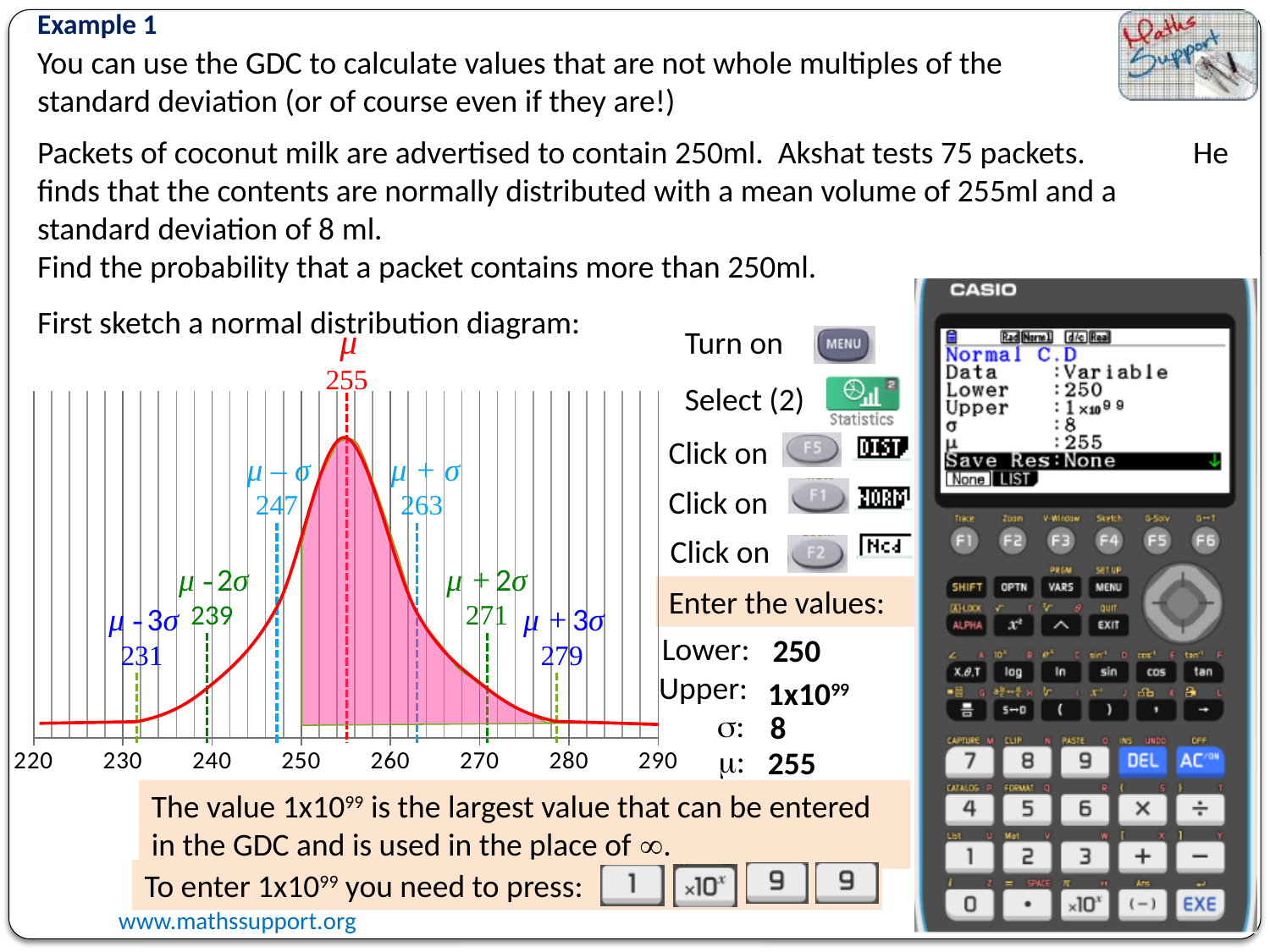
On the normal distribution diagram, what value is labelled at μ − 2σ? 239 On the normal distribution diagram, what value is labelled at μ − 3σ? 231 On the normal distribution diagram, what is the highest value shown on the horizontal axis? 290 On the normal distribution diagram, what value is labelled at the mean μ? 255 On the normal distribution diagram, what value is labelled at μ + 2σ? 271 On the normal distribution diagram, which is larger: the value at μ + 2σ or the value at μ + 3σ? μ + 3σ On the normal distribution diagram, what is the lowest value shown on the horizontal axis? 220 On the normal distribution diagram, what value is labelled at μ − σ? 247 On the normal distribution diagram, what value is labelled at μ + 3σ? 279 On the normal distribution diagram, from which x value does the pink shaded region start? 250 On the normal distribution diagram, what is the difference between the values labelled at μ + σ and μ − σ? 16 On the normal distribution diagram, what value is labelled at μ + σ? 263